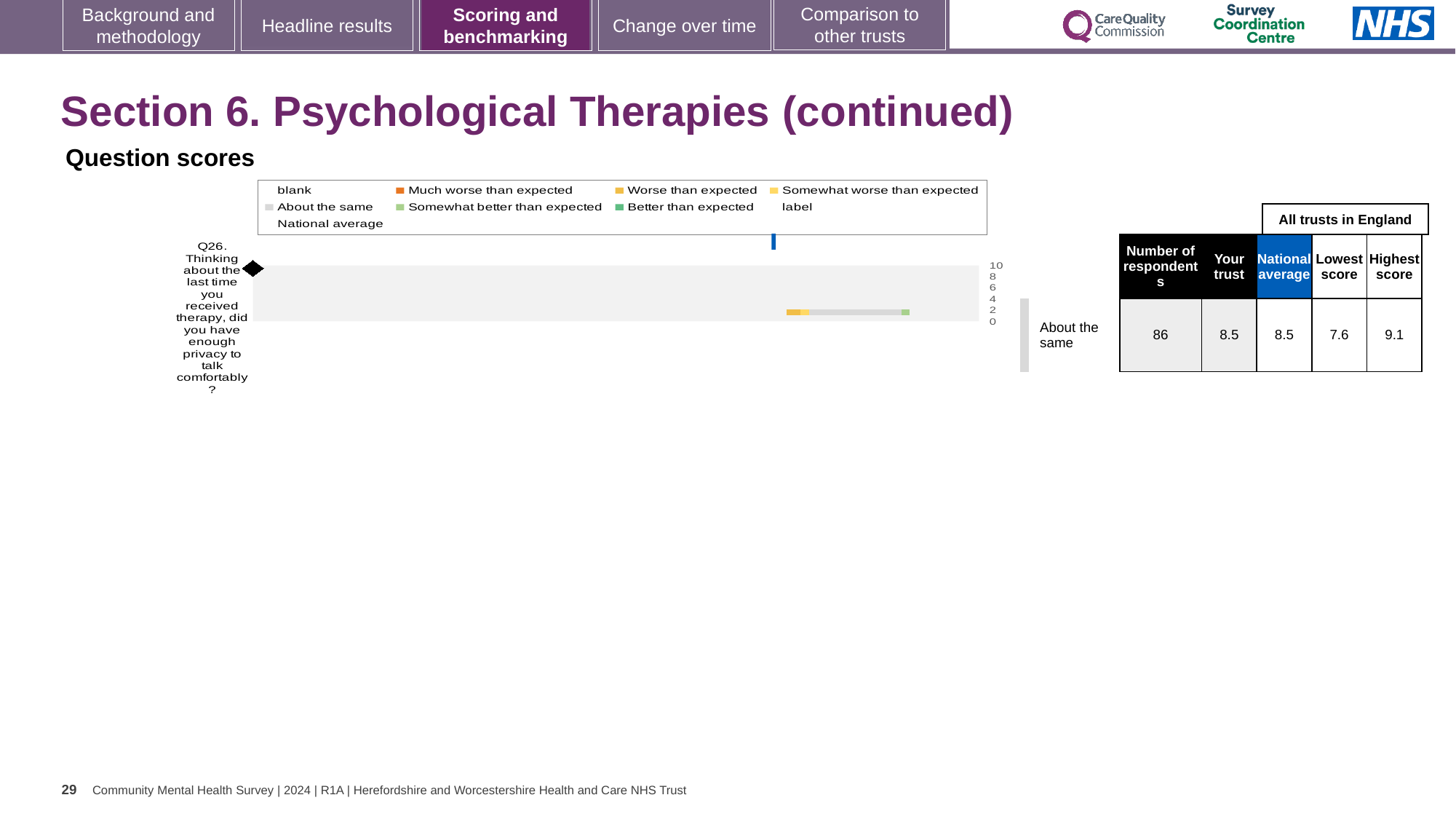
In the table beside the chart, what is the number of respondents for Q26? 86 How many survey questions are plotted in the Question scores chart? 1 In the table beside the chart, what is the difference between the highest score and the lowest score for Q26? 1.5 In the table beside the chart, what is the national average score for Q26? 8.5 In the table beside the chart, which is larger for Q26: the highest score or the 'Your trust' score? Highest score What kind of chart is shown under 'Question scores'? bar chart In the table beside the chart, what is the 'Your trust' score for Q26? 8.5 Which question is plotted in the Question scores chart? Q26 In the table beside the chart, what is the highest score among all trusts in England for Q26? 9.1 What benchmark category is shown for Q26 next to the chart? About the same How many entries does the legend of the Question scores chart list? 9 In the table beside the chart, what is the lowest score among all trusts in England for Q26? 7.6